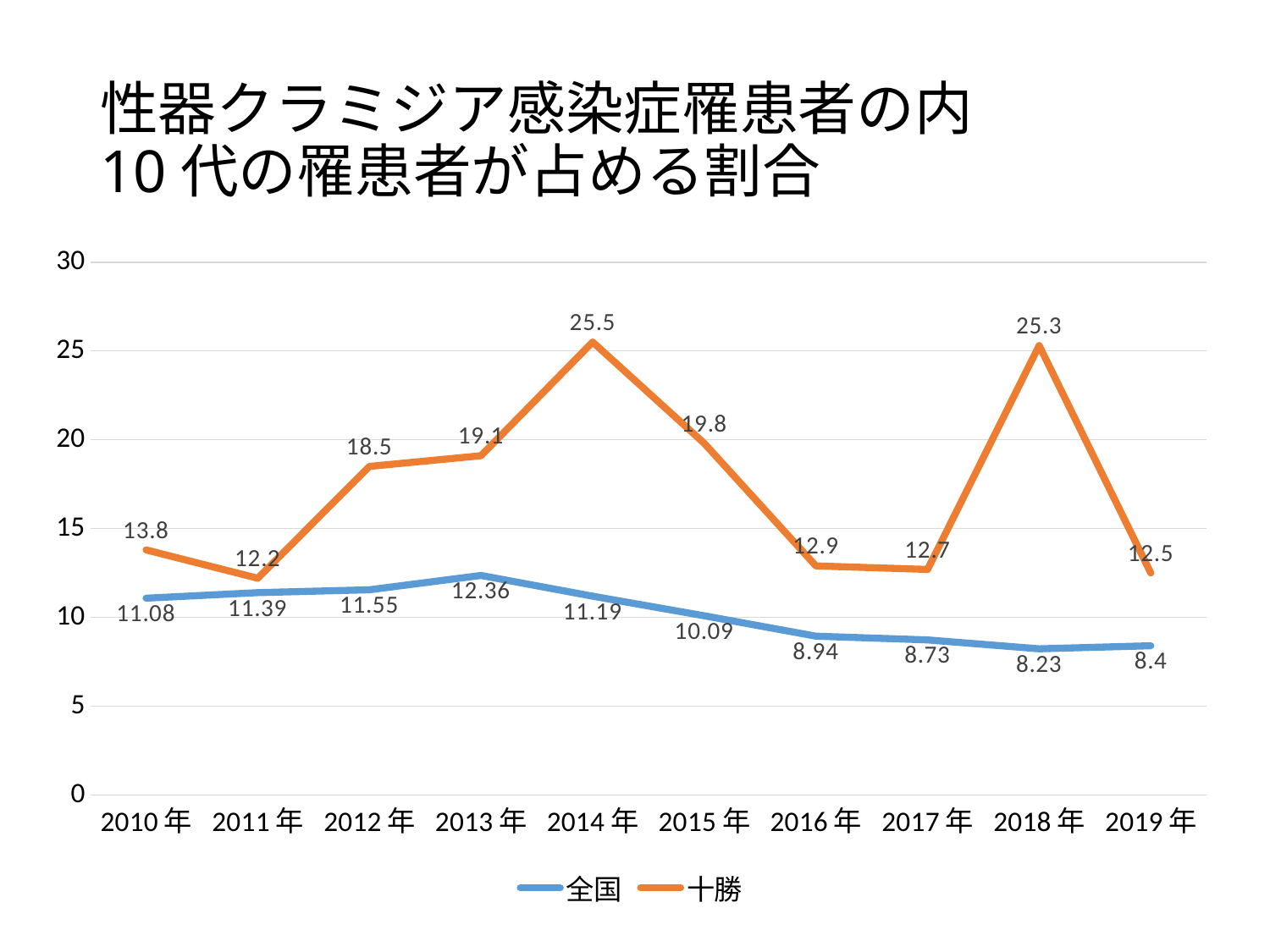
What is the difference between the 十勝 and 全国 values in 2018年? 17.07 How many years are plotted along the x axis? 10 In which year is the 全国 value lowest? 2018年 Does the 全国 value rise or fall from 2013年 to 2019年? fall How many series does the legend list? 2 What is the value for 十勝 in 2014年? 25.5 What type of chart is shown on the slide? line chart What is the value for 十勝 in 2019年? 12.5 Which is larger in 2011年, the 全国 value or the 十勝 value? 十勝 What is the value for 全国 in 2013年? 12.36 In which year is the 十勝 value highest? 2014年 Which series is drawn in orange? 十勝